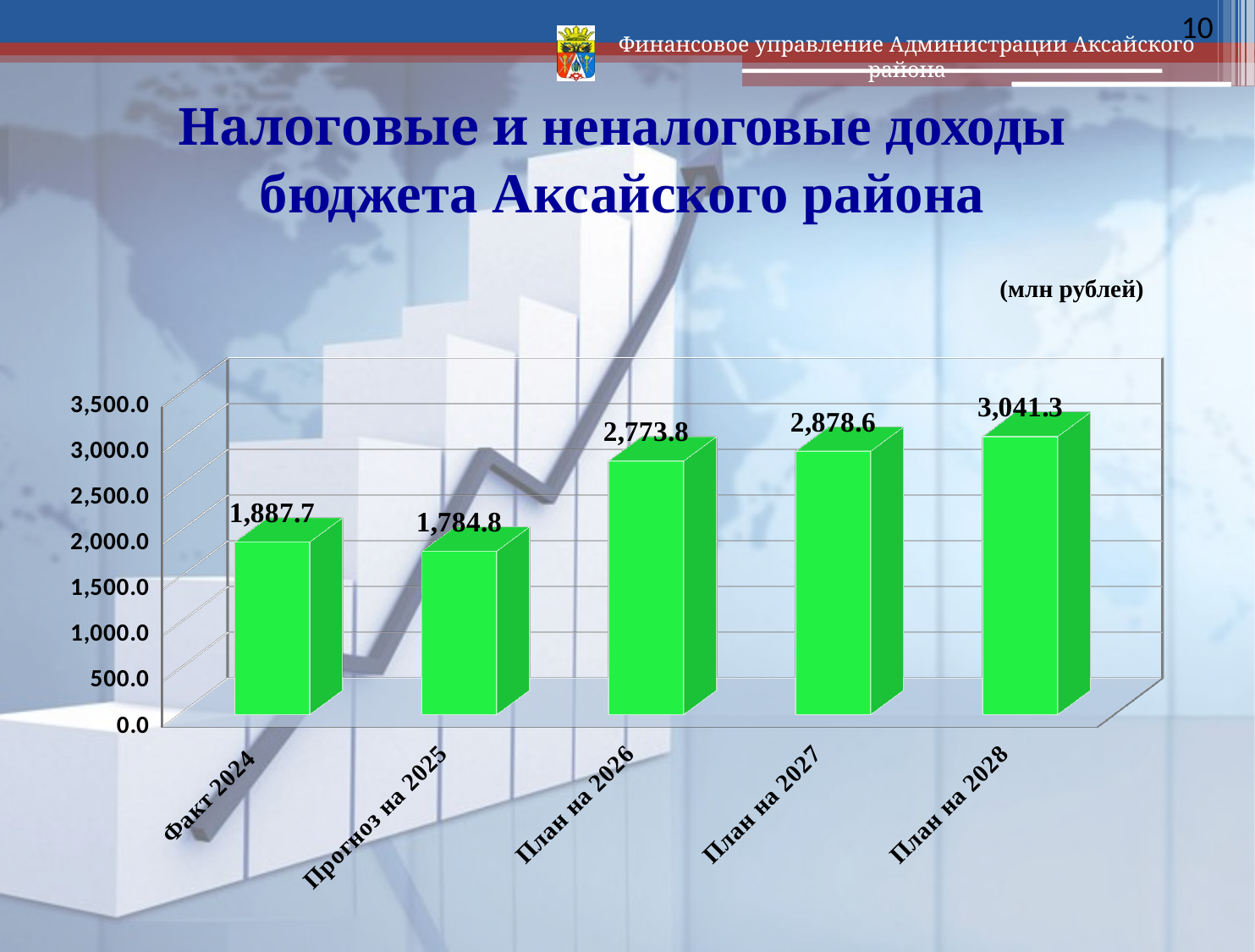
What is the value for Факт 2024? 1,887.7 What is the difference between the values for План на 2028 and Факт 2024? 1,153.6 Is the value for План на 2026 greater or less than 2,500.0? greater Which is larger, the value for Факт 2024 or the value for Прогноз на 2025? Факт 2024 What is the difference between the values for План на 2027 and План на 2026? 104.8 What is the value for План на 2028? 3,041.3 Which category has the lowest value? Прогноз на 2025 In what units are the values on the chart expressed? млн рублей How many categories are shown on the chart? 5 What is the value for Прогноз на 2025? 1,784.8 What kind of chart is shown on the slide? bar chart Which category has the highest value? План на 2028